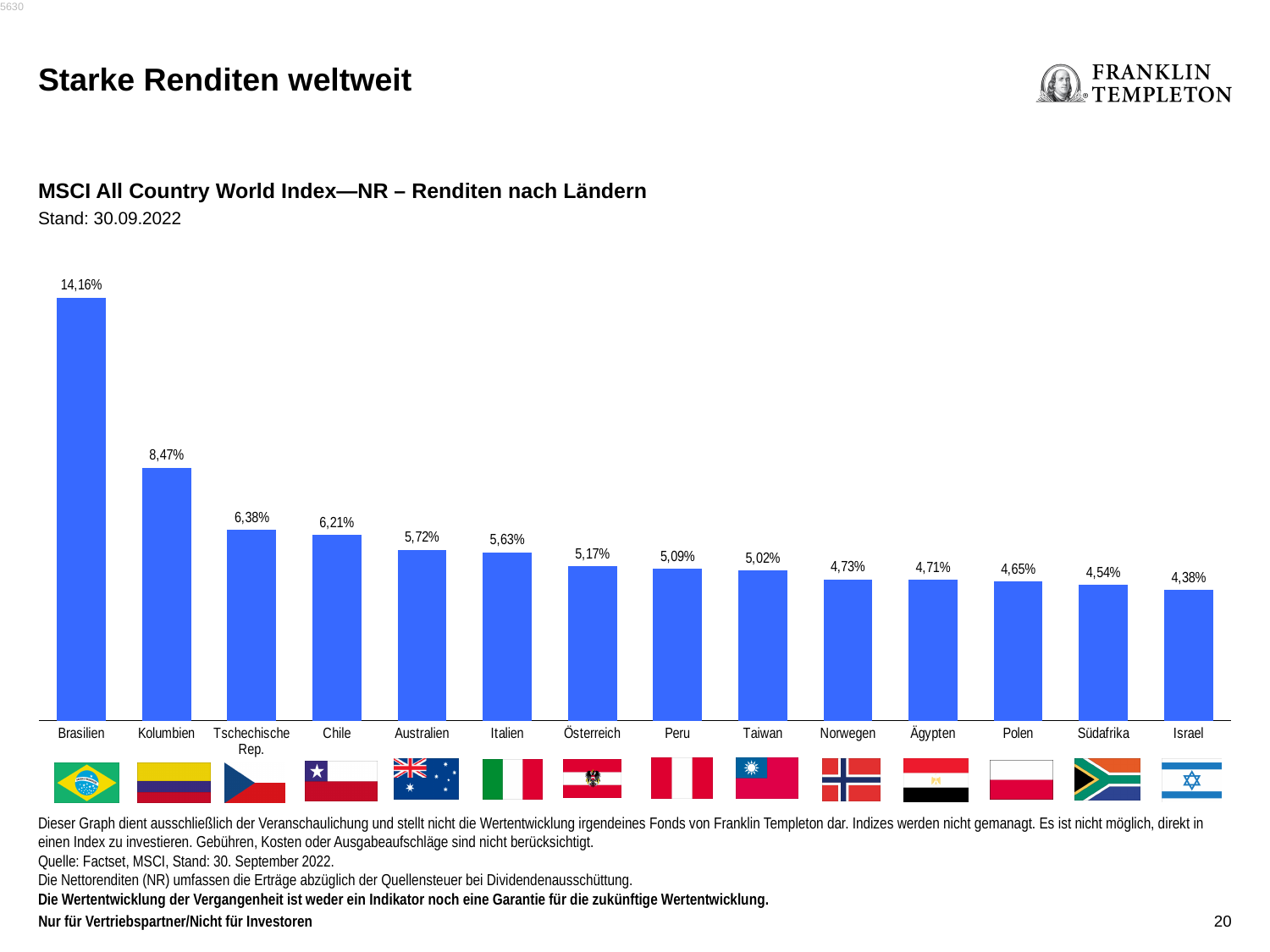
What is the value for Taiwan? 5,02% How many countries are shown in the chart? 14 Do the values rise or fall from left to right across the chart? Fall Which country has the lowest value? Israel What is the value for Tschechische Rep.? 6,38% What is the difference between the values for Brasilien and Kolumbien? 5,69% Which country has the highest value? Brasilien What kind of chart is shown? Bar chart What is the value for Brasilien? 14,16% Which is larger, the value for Kolumbien or the value for Chile? Kolumbien What is the difference between the values for Chile and Australien? 0,49% What is the value for Israel? 4,38%